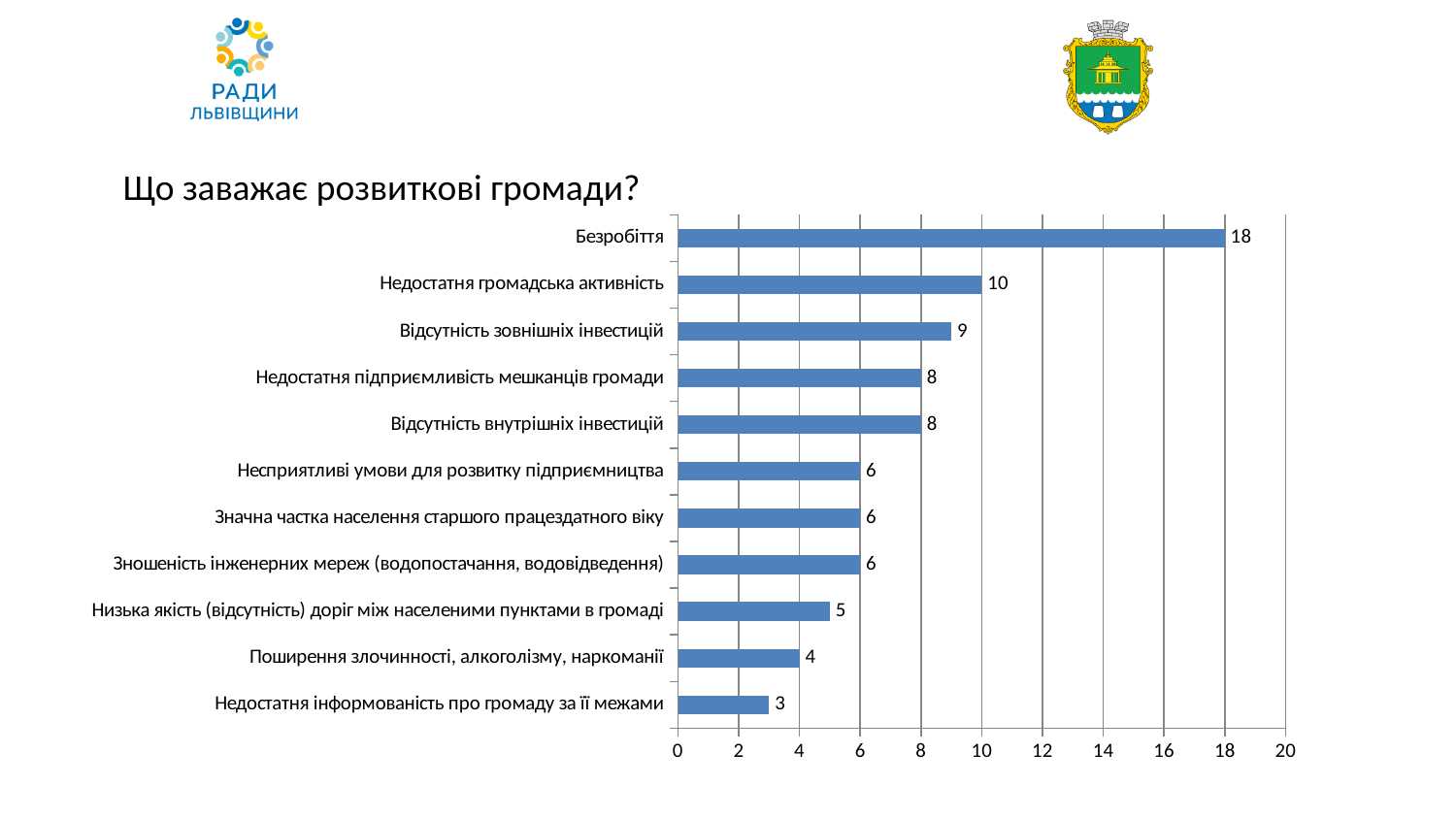
Which is larger: the value for Відсутність зовнішніх інвестицій or the value for Поширення злочинності, алкоголізму, наркоманії? Відсутність зовнішніх інвестицій What is the title of the chart? Що заважає розвиткові громади? Is the value for Безробіття greater or less than 16? greater What is the value for Низька якість (відсутність) доріг між населеними пунктами в громаді? 5 Which category has the highest value? Безробіття What kind of chart is shown on the slide? bar chart What is the value for Недостатня інформованість про громаду за її межами? 3 What is the value for Безробіття? 18 Which category has the lowest value? Недостатня інформованість про громаду за її межами How many categories are shown in the chart? 11 What is the difference between the values for Безробіття and Недостатня громадська активність? 8 What is the value for Недостатня громадська активність? 10